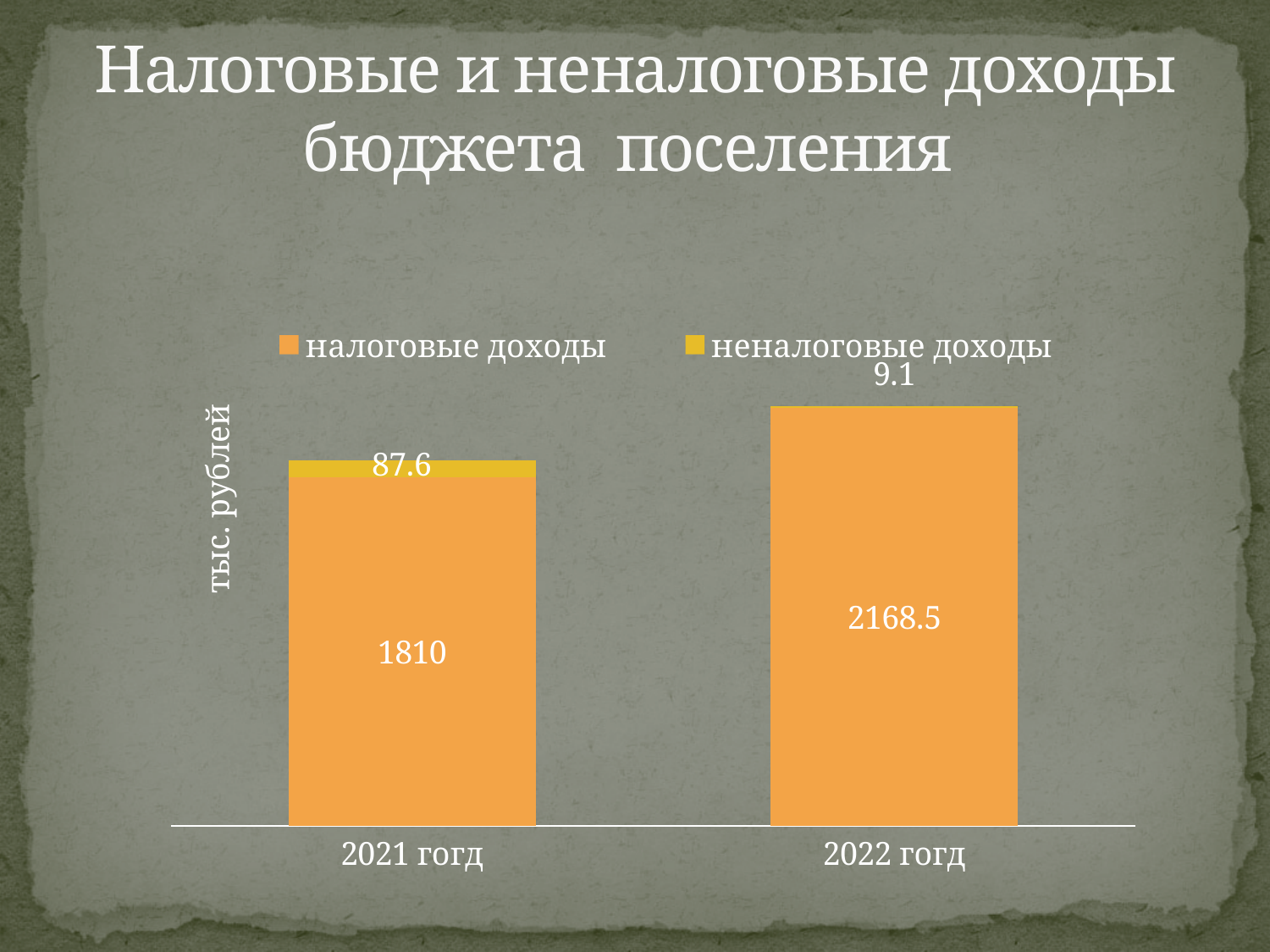
What is the value of налоговые доходы for 2022 гогд? 2168.5 What is the total of the stacked bar for 2021 гогд? 1897.6 Which year has the higher value of налоговые доходы? 2022 гогд What is the value of неналоговые доходы for 2022 гогд? 9.1 Which year has the lower value of неналоговые доходы? 2022 гогд What kind of chart is shown on the slide? Stacked bar chart How many series does the legend list? 2 What is the difference in налоговые доходы between 2022 гогд and 2021 гогд? 358.5 What is the value of налоговые доходы for 2021 гогд? 1810 What is the difference in неналоговые доходы between 2021 гогд and 2022 гогд? 78.5 What is the total of the stacked bar for 2022 гогд? 2177.6 What is the value of неналоговые доходы for 2021 гогд? 87.6